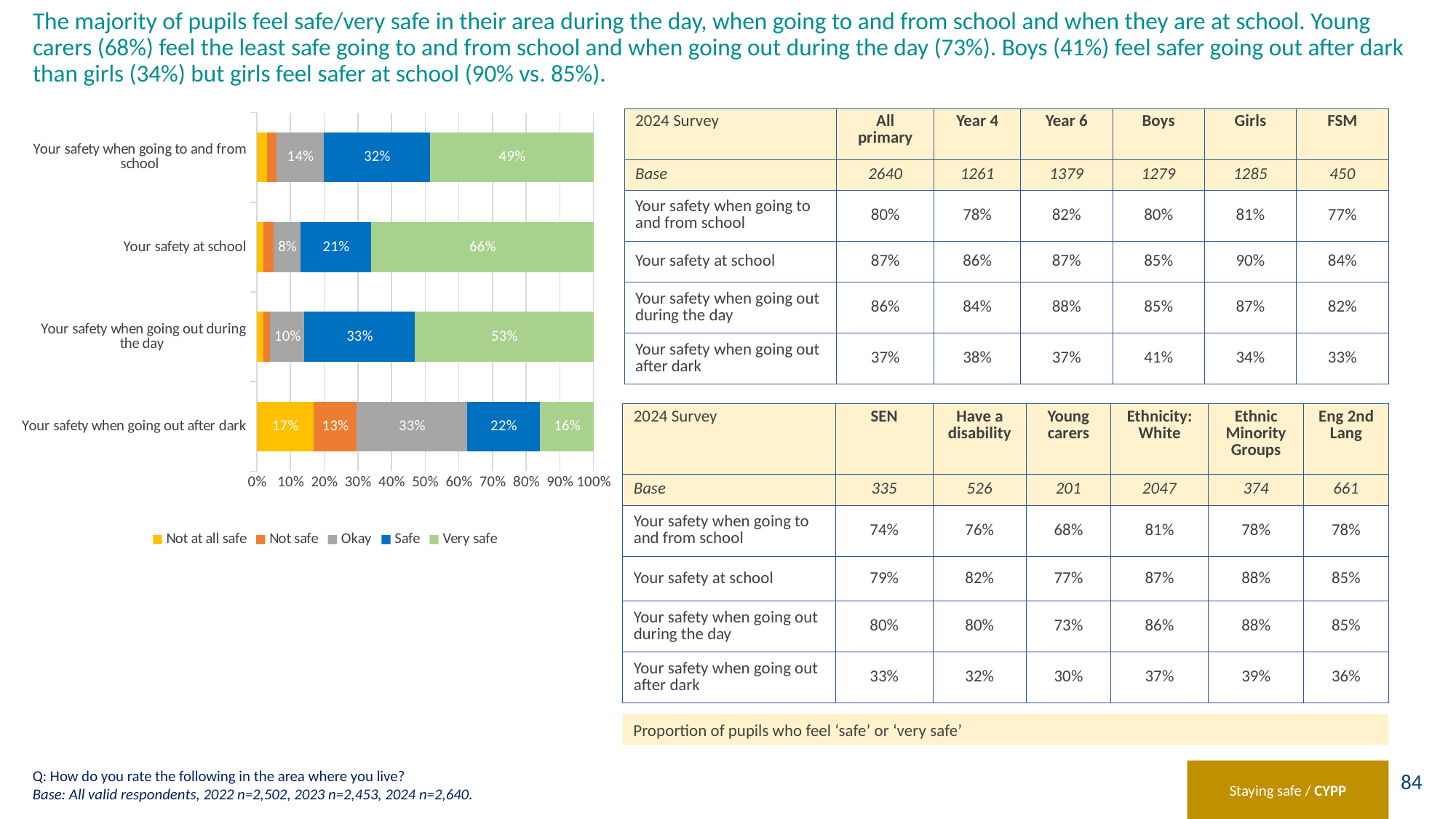
In the bar chart, which category has the lowest 'Very safe' percentage? Your safety when going out after dark In the bar chart, which is larger: the 'Okay' value for 'Your safety when going out after dark' or the 'Okay' value for 'Your safety at school'? Your safety when going out after dark In the bar chart, what percentage of pupils said 'Not at all safe' for 'Your safety when going out after dark'? 17% In the bar chart, what percentage of pupils said 'Safe' for 'Your safety when going out during the day'? 33% What type of chart is shown on the left of the slide? Stacked bar chart How many categories are shown in the bar chart? 4 In the bar chart, what percentage of pupils said 'Very safe' for 'Your safety at school'? 66% In the bar chart, which category has the highest 'Very safe' percentage? Your safety at school In the bar chart, what is the difference in percentage points between the 'Okay' value for 'Your safety when going out after dark' and for 'Your safety when going to and from school'? 19 percentage points In the bar chart, what is the difference in percentage points between the 'Very safe' value for 'Your safety at school' and for 'Your safety when going to and from school'? 17 percentage points In the bar chart, what percentage of pupils said 'Not safe' for 'Your safety when going out after dark'? 13% How many series does the legend of the bar chart list? 5